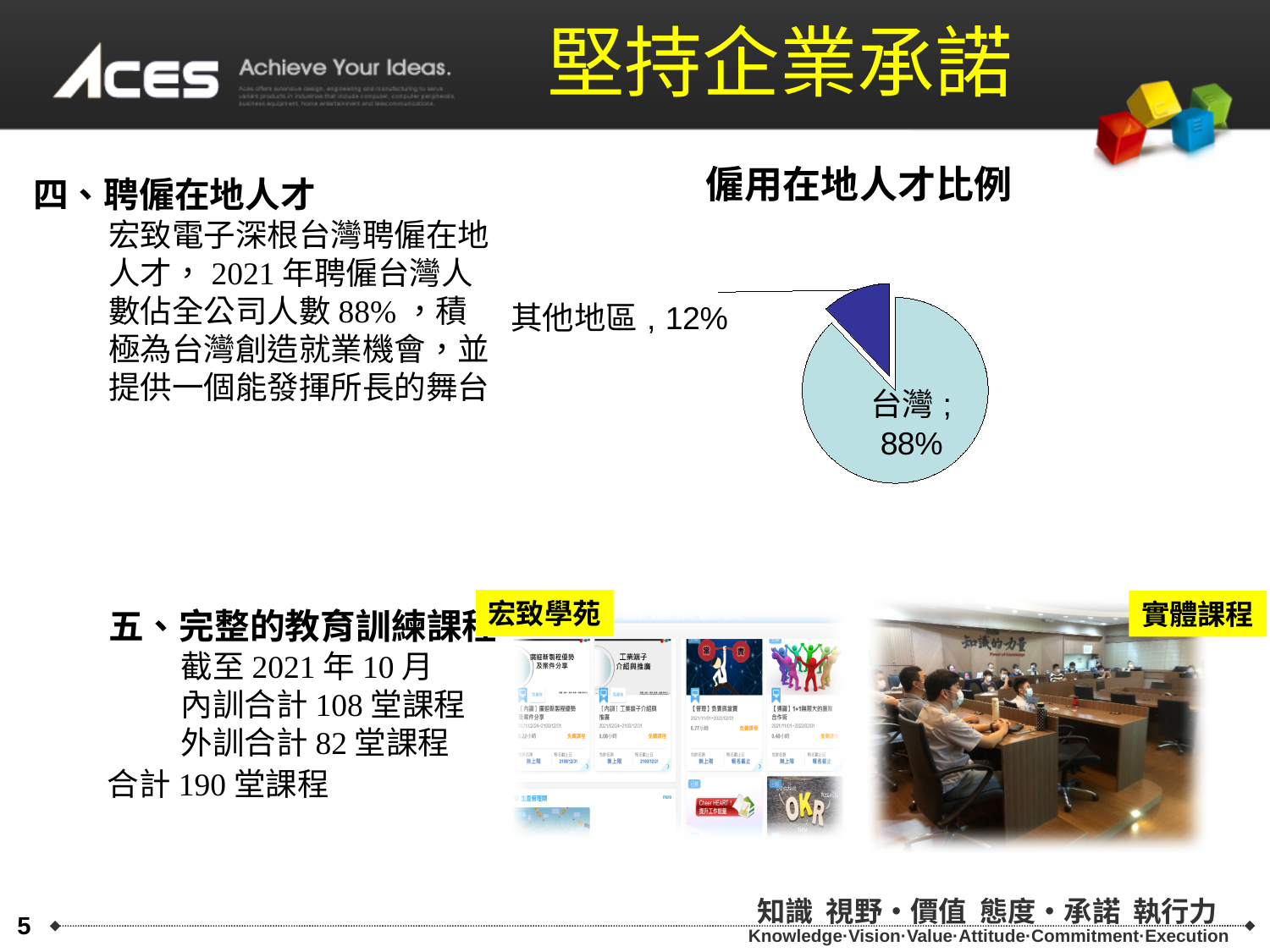
Which slice of the pie chart 僱用在地人才比例 is the smallest? 其他地區 In the pie chart 僱用在地人才比例, what is the difference in percentage points between the 台灣 slice and the 其他地區 slice? 76 In the pie chart 僱用在地人才比例, what colour is the 其他地區 slice? dark blue What is the title of the pie chart on the slide? 僱用在地人才比例 In the pie chart 僱用在地人才比例, what share is labelled for 台灣? 88% In the pie chart 僱用在地人才比例, what share is labelled for 其他地區? 12% In the pie chart 僱用在地人才比例, do the two labelled slices add up to 100%? yes Which slice of the pie chart 僱用在地人才比例 is the largest? 台灣 What kind of chart is shown under the title 僱用在地人才比例? pie chart How many slices does the pie chart 僱用在地人才比例 have? 2 In the pie chart 僱用在地人才比例, which is larger, the 台灣 slice or the 其他地區 slice? 台灣